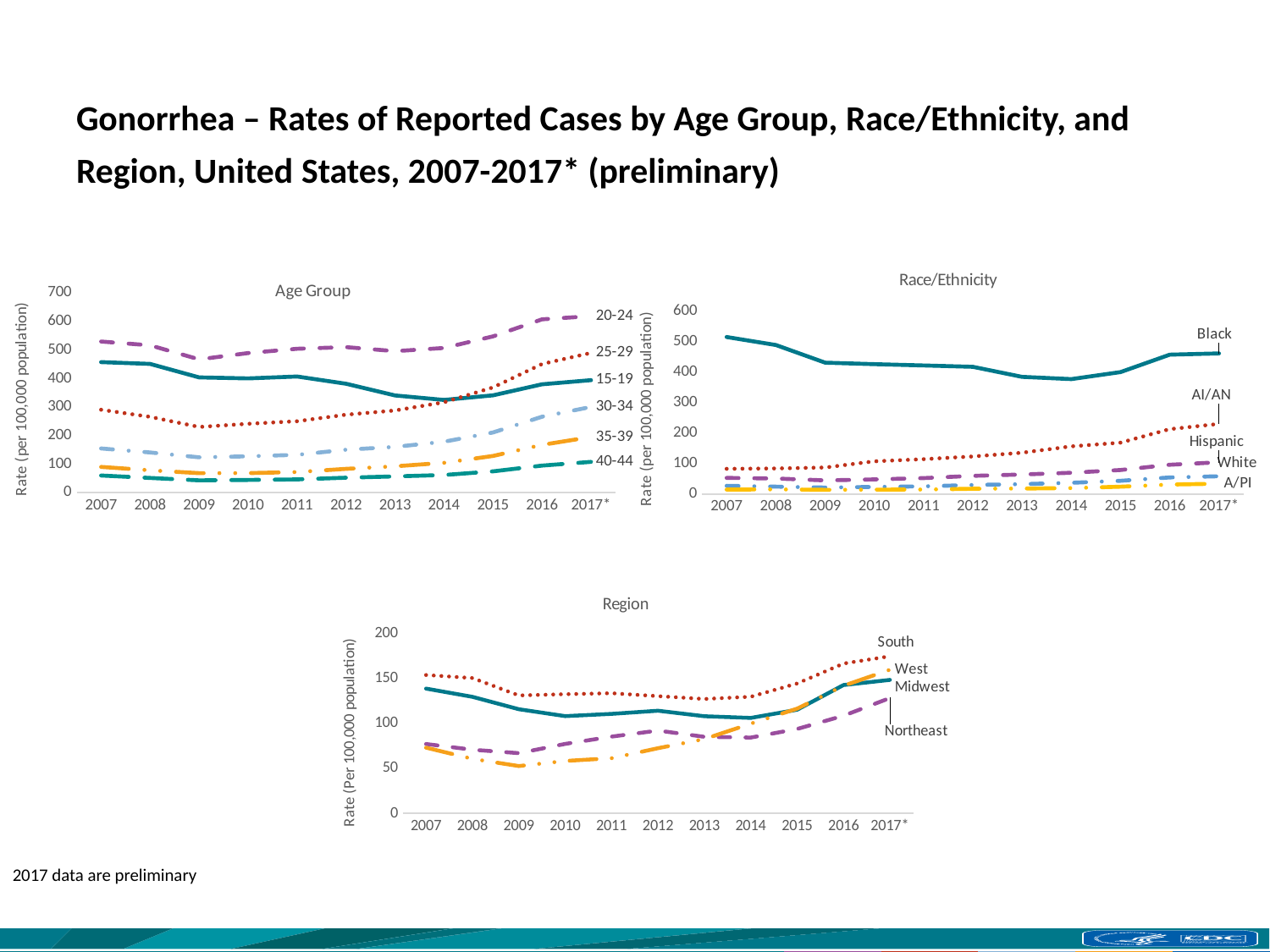
In the Age Group chart, which age group has the lowest rate in 2017*? 40-44 In the Age Group chart, is the value for 40-44 in 2007 greater or less than 100? less In the Region chart, which region has the highest rate in 2017*? South In the Race/Ethnicity chart, is the value for Black in 2014 greater or less than 400? less In the Race/Ethnicity chart, which group has the highest rate across all years? Black In the Race/Ethnicity chart, is the value for AI/AN in 2017* greater or less than 200? greater What kind of chart is the Age Group chart? line chart How many age-group series are plotted in the Age Group chart? 6 In the Region chart, which is larger in 2007, the value for South or the value for Midwest? South How many years are plotted along the x axis of the Race/Ethnicity chart? 11 In the Age Group chart, does the 25-29 line rise or fall from 2007 to 2017*? rises In the Age Group chart, which age group has the highest rate in 2017*? 20-24